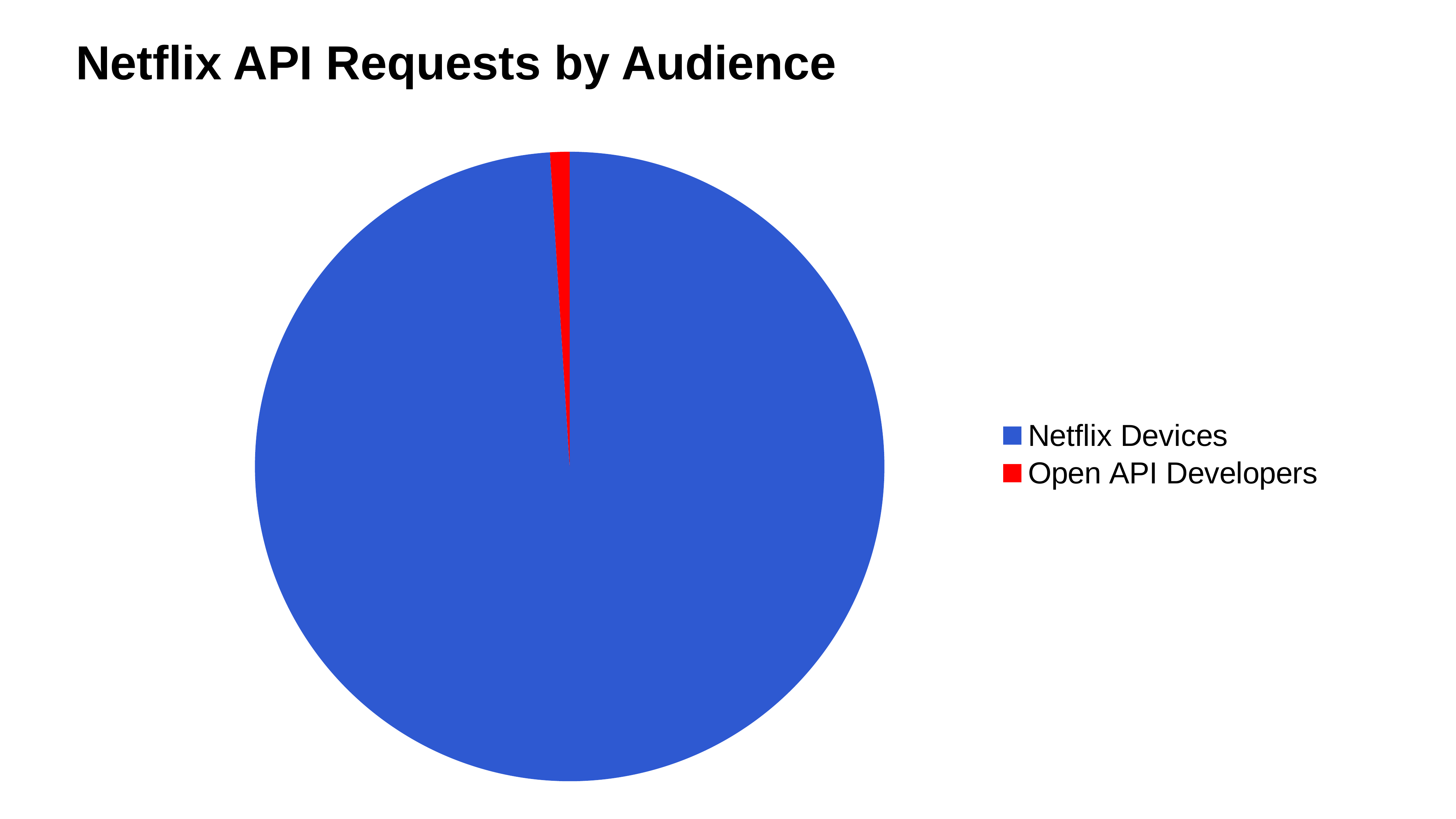
Which audience has the smallest share of Netflix API requests? Open API Developers Which audience has the largest share of Netflix API requests? Netflix Devices How many entries does the legend list? 2 What colour is the Open API Developers slice? red Which slice is larger, Netflix Devices or Open API Developers? Netflix Devices What is the title of the chart? Netflix API Requests by Audience How many slices does the pie chart have? 2 Is the share for Netflix Devices greater or less than 50%? greater What kind of chart is shown on the slide? pie chart Is the share for Open API Developers greater or less than 10%? less